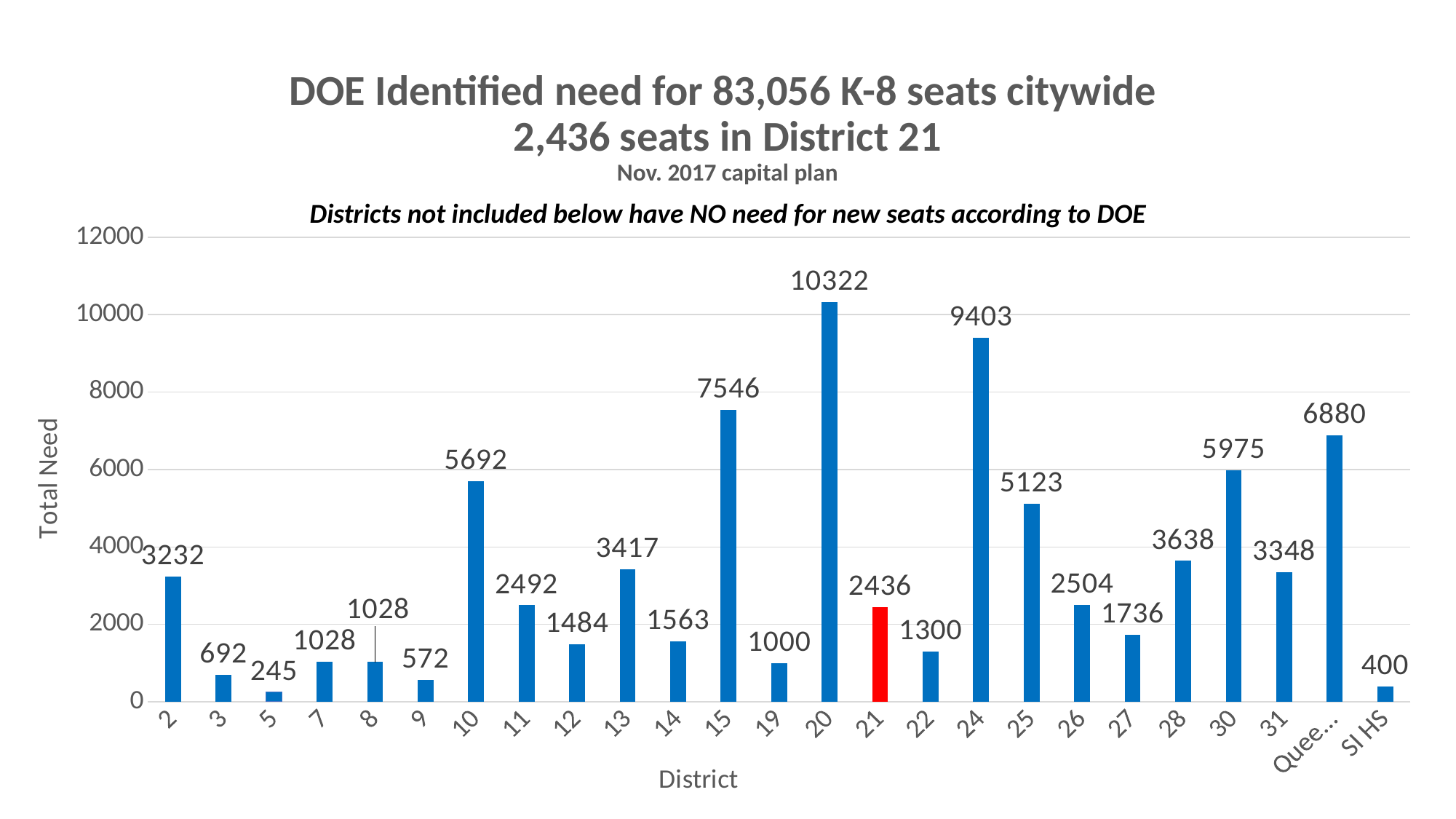
Is the value for District 25 greater or less than 4000? greater How many districts are shown on the x axis? 25 What is the total need for SI HS? 400 What is the difference in total need between District 20 and District 24? 919 Which has a larger total need, District 10 or District 30? District 30 What is the total need for District 15? 7546 Which district has the highest total need? 20 What kind of chart is shown on the slide? Bar chart What is the difference in total need between District 21 and District 22? 1136 Which district has the lowest total need? 5 What is the total need for District 21? 2436 Which district's bar is coloured red? 21